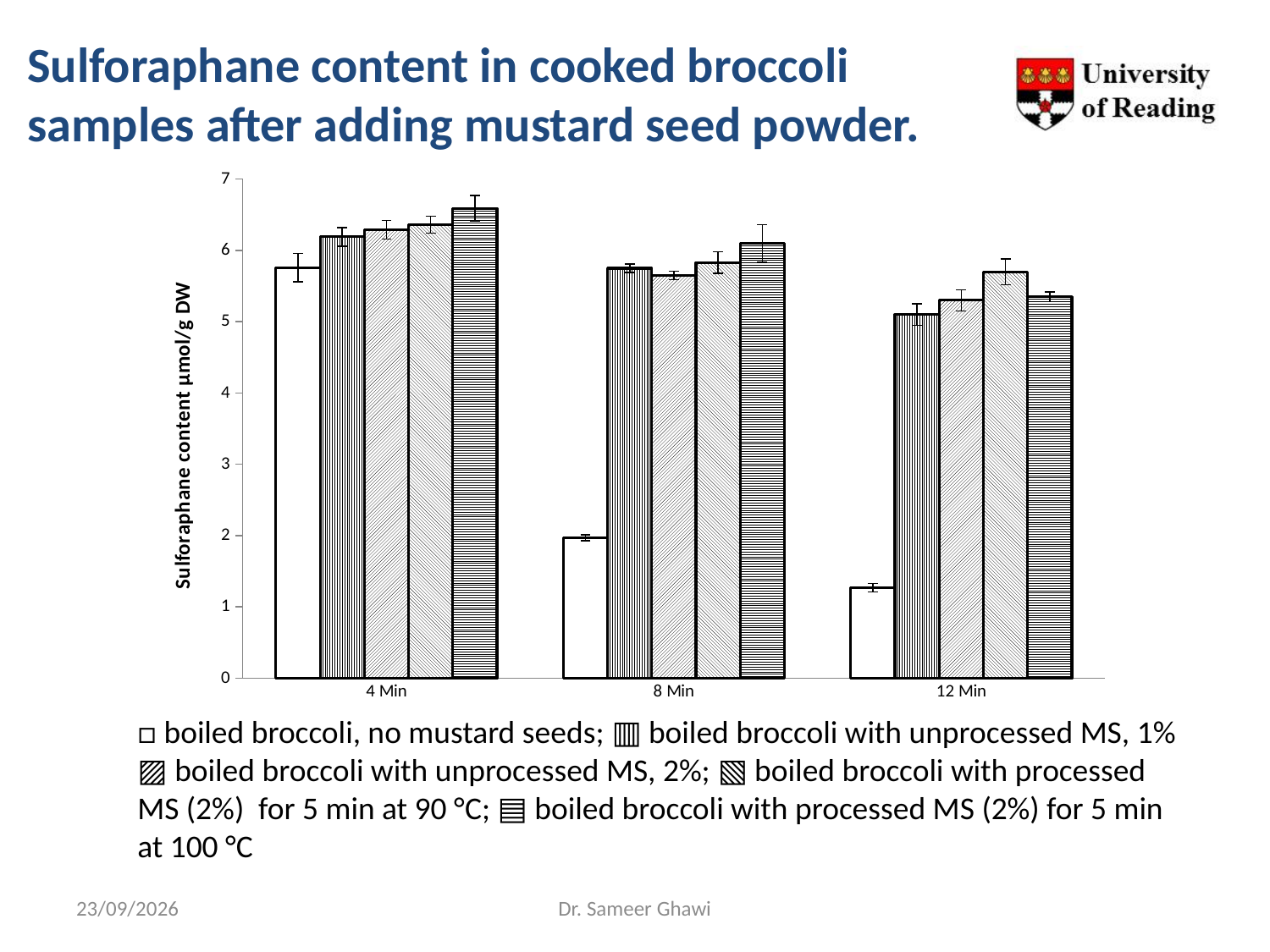
Is the value for boiled broccoli with no mustard seeds at 12 Min greater or less than 2? less Is the value for boiled broccoli with processed MS (2%) for 5 min at 90 °C at 12 Min greater or less than 5? greater How many cooking-time categories are shown on the x axis? 3 How does the sulforaphane content of boiled broccoli with no mustard seeds change from 4 Min to 12 Min? it falls Which sample type has the lowest sulforaphane content in the 12 Min group? boiled broccoli, no mustard seeds What is the label of the y axis? Sulforaphane content µmol/g DW How many sample types does the caption below the chart describe? 5 How many bars are plotted in each cooking-time group? 5 Is the value for boiled broccoli with no mustard seeds at 4 Min greater or less than 5? greater Which sample type has the highest sulforaphane content in the 4 Min group? boiled broccoli with processed MS (2%) for 5 min at 100 °C What kind of chart is shown on the slide? bar chart